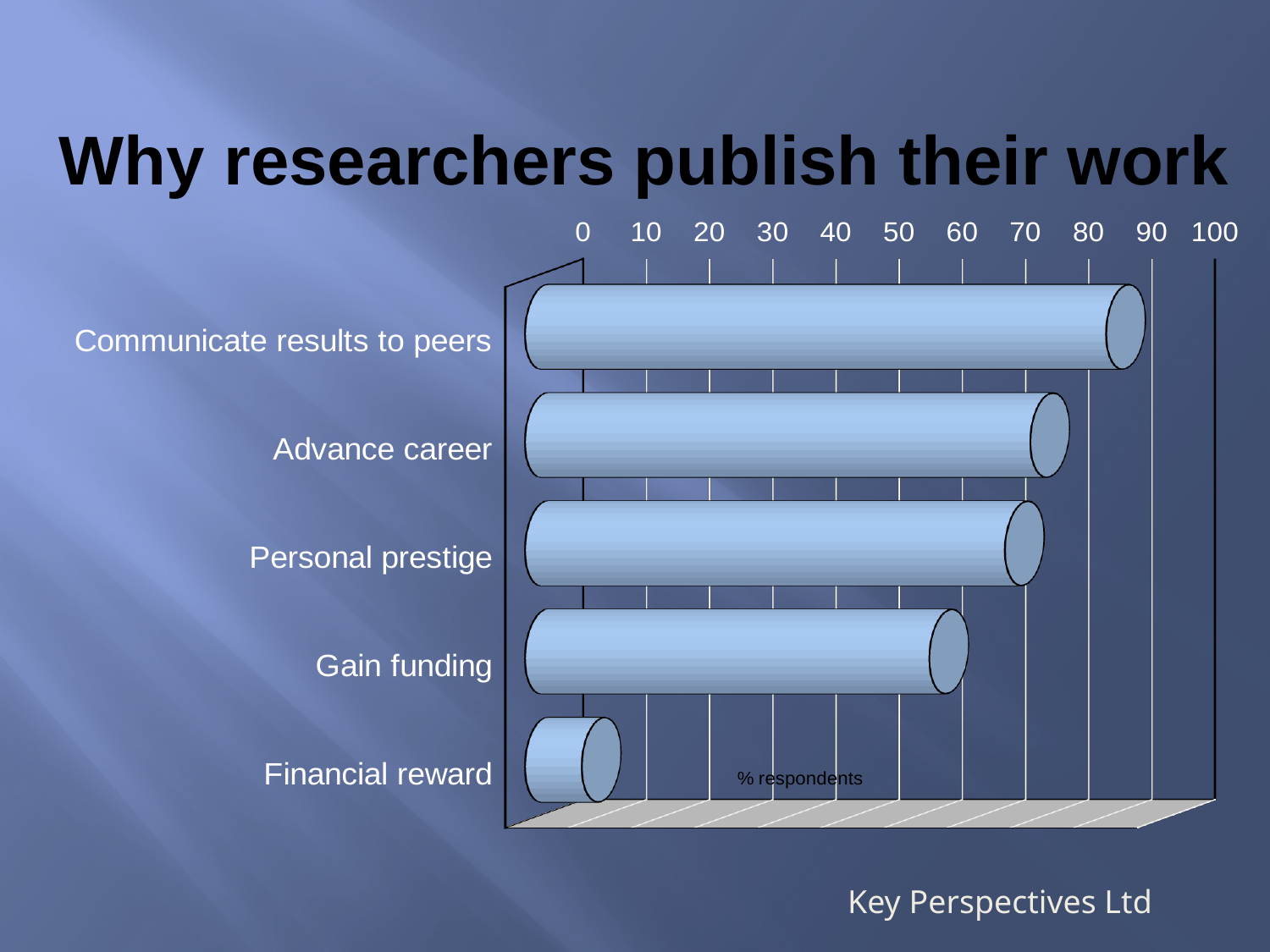
Is the value for Personal prestige greater or less than 80? less What kind of chart is shown on the slide? bar chart Is the value for Gain funding greater or less than 50? greater Which category has the highest value? Communicate results to peers Which is larger, the value for Personal prestige or the value for Financial reward? Personal prestige Which category has the lowest value? Financial reward How many categories are plotted in the chart? 5 What is the title of the chart? Why researchers publish their work Which is larger, the value for Advance career or the value for Gain funding? Advance career Is the value for Communicate results to peers greater or less than 80? greater